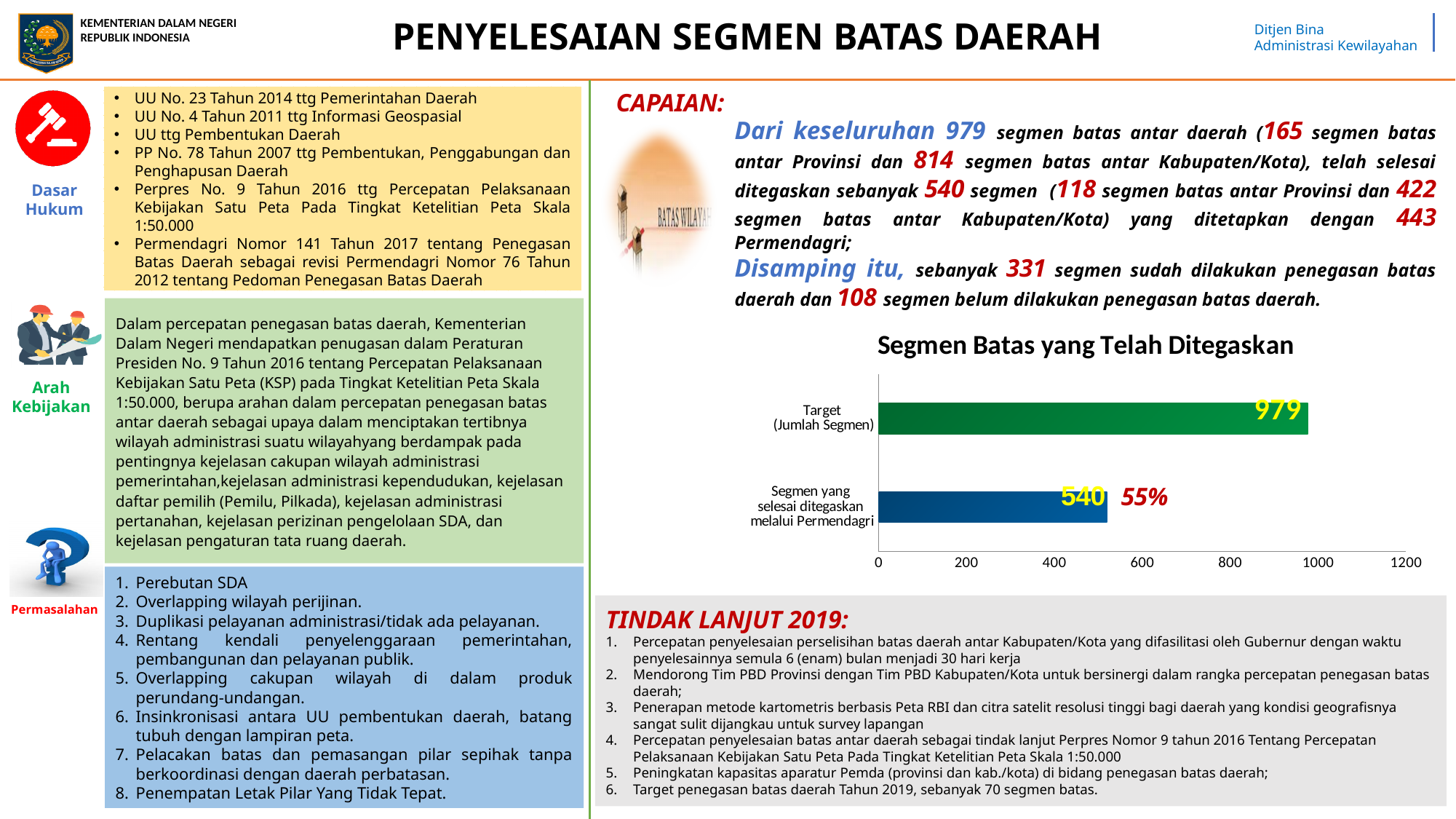
What type of chart is shown under the heading "Segmen Batas yang Telah Ditegaskan"? bar chart What is the value of the "Segmen yang selesai ditegaskan melalui Permendagri" bar in the chart? 540 How many bars are plotted in the chart? 2 Which category has the highest value in the chart? Target (Jumlah Segmen) What is the title of the chart on the slide? Segmen Batas yang Telah Ditegaskan What percentage is printed next to the "Segmen yang selesai ditegaskan melalui Permendagri" bar? 55% What is the value of the "Target (Jumlah Segmen)" bar in the chart? 979 What is the difference between the Target value and the Segmen yang selesai ditegaskan value in the chart? 439 What is the maximum value shown on the x axis of the chart? 1200 Which is larger in the chart: the Target bar or the Segmen yang selesai ditegaskan bar? Target (Jumlah Segmen) Is the value for "Segmen yang selesai ditegaskan melalui Permendagri" greater or less than 600? less Which category has the lowest value in the chart? Segmen yang selesai ditegaskan melalui Permendagri